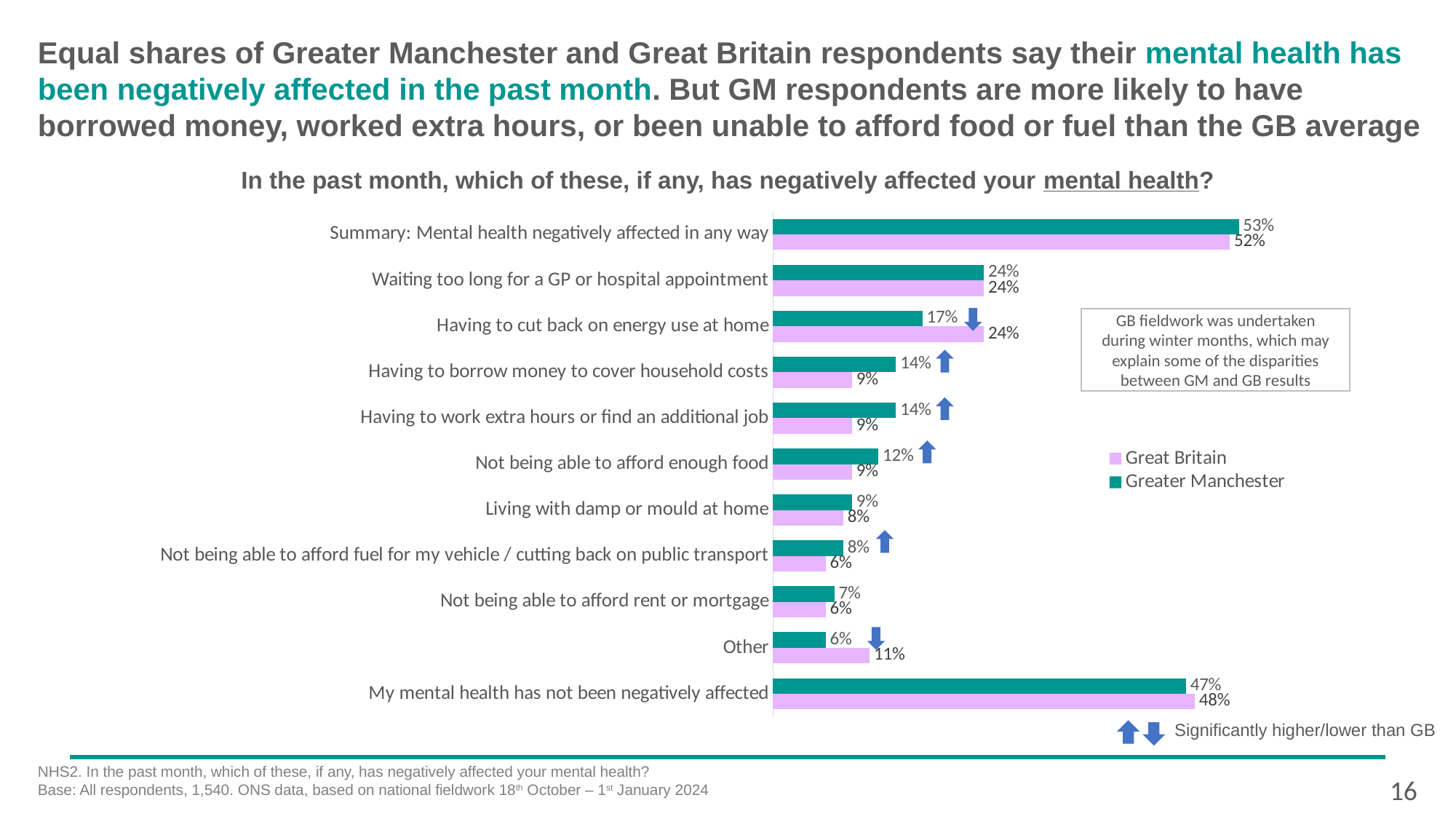
Which category has the lowest Greater Manchester value? Other For 'Other', which is larger: the Greater Manchester value or the Great Britain value? Great Britain What percentage of Great Britain respondents said their mental health has not been negatively affected? 48% What is the Great Britain value for 'Other'? 11% What percentage of Greater Manchester respondents said having to cut back on energy use at home negatively affected their mental health? 17% For 'Not being able to afford enough food', which is larger: the Greater Manchester value or the Great Britain value? Greater Manchester What type of chart is shown on the slide? Bar chart How many categories are shown on the chart? 11 How many series does the legend list? 2 What is the difference between the Greater Manchester and Great Britain values for having to borrow money to cover household costs? 5 percentage points Excluding the summary and 'not negatively affected' rows, which factor has the highest Greater Manchester value? Waiting too long for a GP or hospital appointment What is the difference between the Great Britain and Greater Manchester values for having to cut back on energy use at home? 7 percentage points